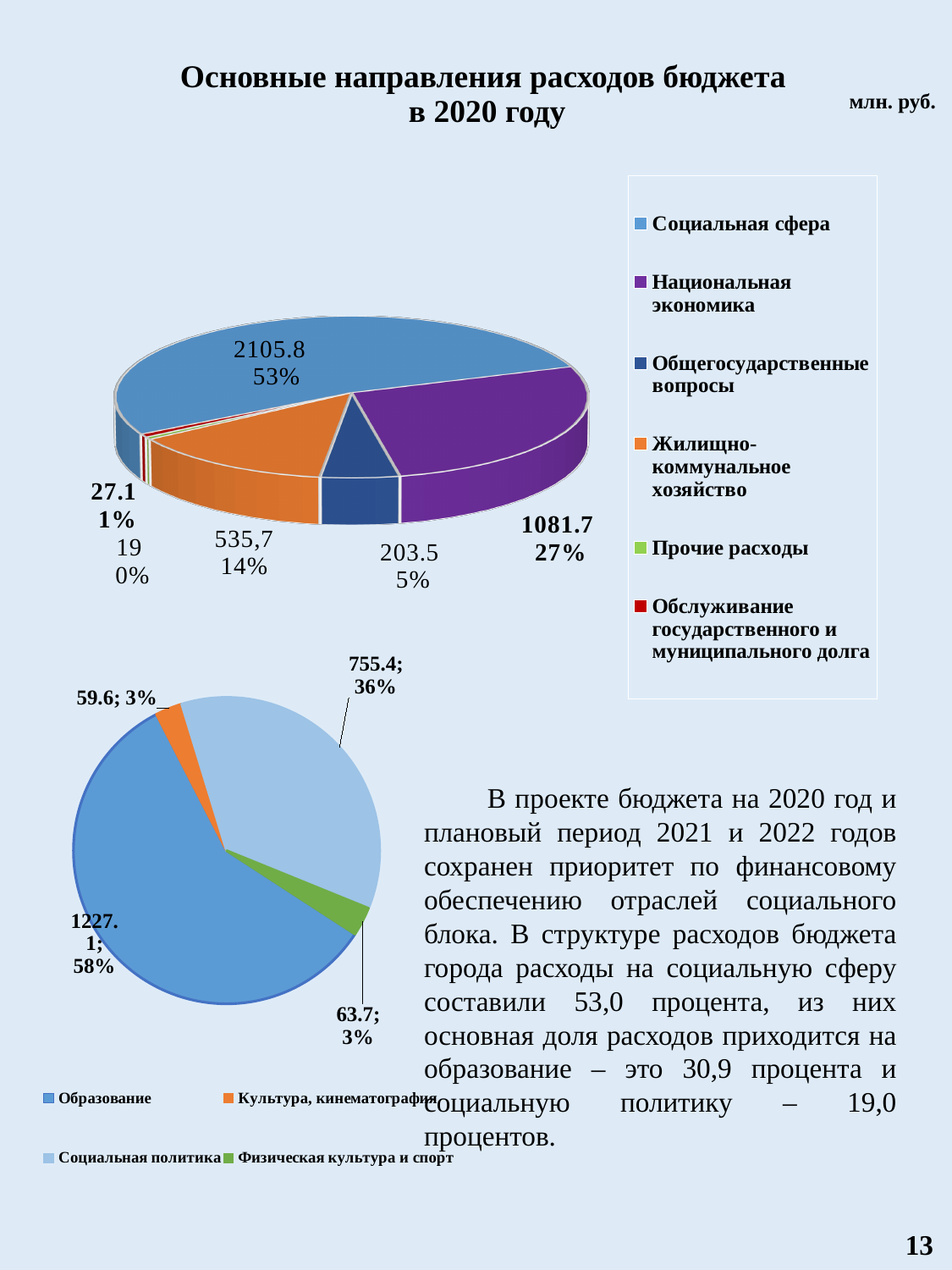
In the top pie chart, what value is shown for Жилищно-коммунальное хозяйство? 535,7 In the top pie chart, which category has the largest share? Социальная сфера In the top pie chart, what percentage share is shown for Национальная экономика? 27% In the bottom pie chart, which category has the smallest value? Культура, кинематография In the top pie chart, what percentage share is shown for Общегосударственные вопросы? 5% What type of chart is the bottom chart on the slide? Pie chart In the bottom pie chart, what value is shown for Образование? 1227.1 How many categories does the legend of the top pie chart list? 6 In the top pie chart, which is larger: Национальная экономика or Жилищно-коммунальное хозяйство? Национальная экономика In the bottom pie chart, what value is shown for Физическая культура и спорт? 63.7 In the bottom pie chart, what percentage share is shown for Социальная политика? 36% In the top pie chart, what value is shown for Социальная сфера? 2105.8